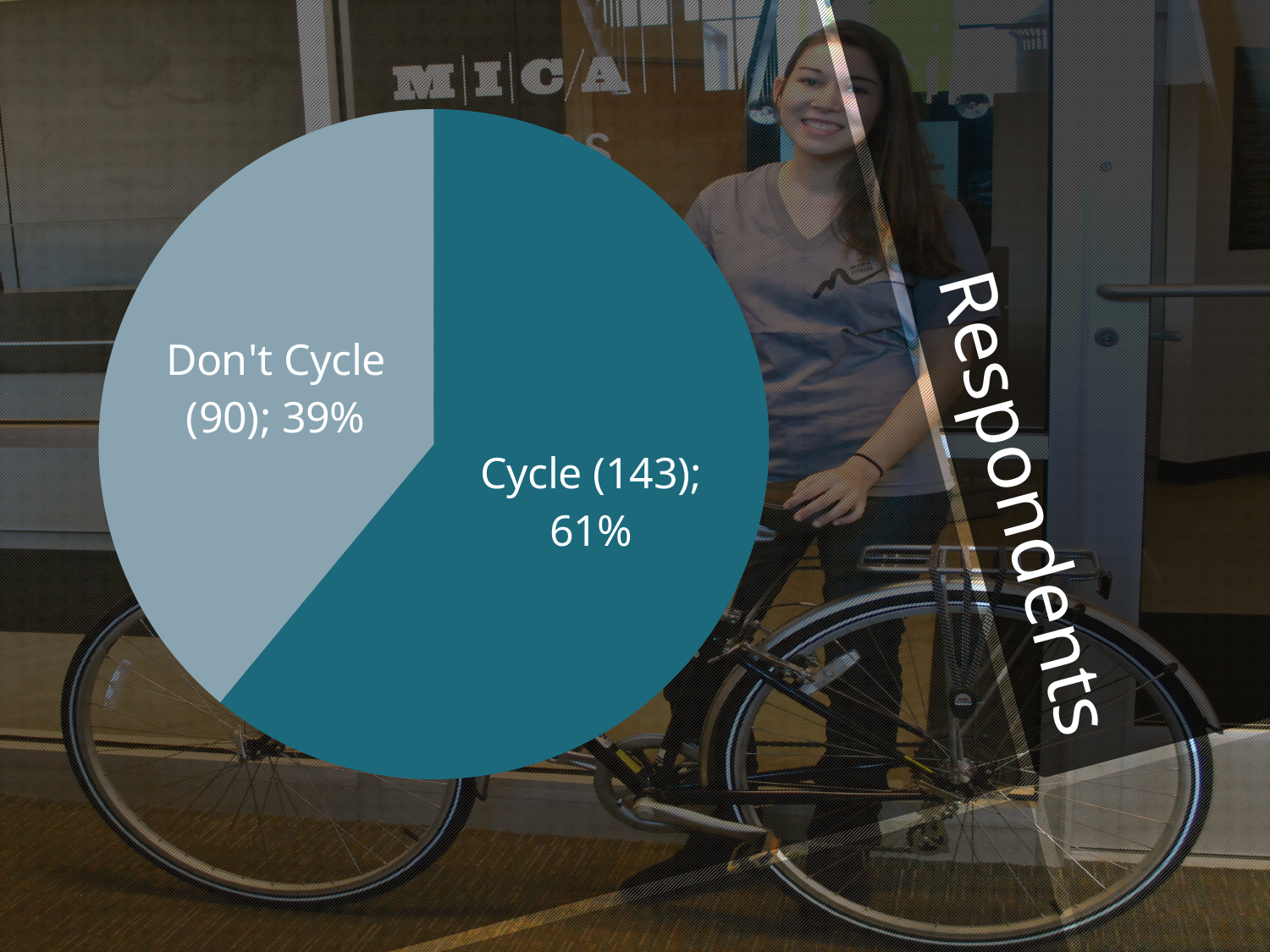
How many slices does the pie chart have? 2 How many respondents don't cycle? 90 What is the title of the chart? Respondents What kind of chart is shown on the slide? pie chart What percentage of respondents don't cycle? 39% Which slice of the pie is the largest? Cycle Which group has more respondents, Cycle or Don't Cycle? Cycle Which slice of the pie is the smallest? Don't Cycle What percentage of respondents cycle? 61% What is the total number of respondents shown in the pie chart? 233 How many more respondents cycle than don't cycle? 53 How many respondents cycle? 143